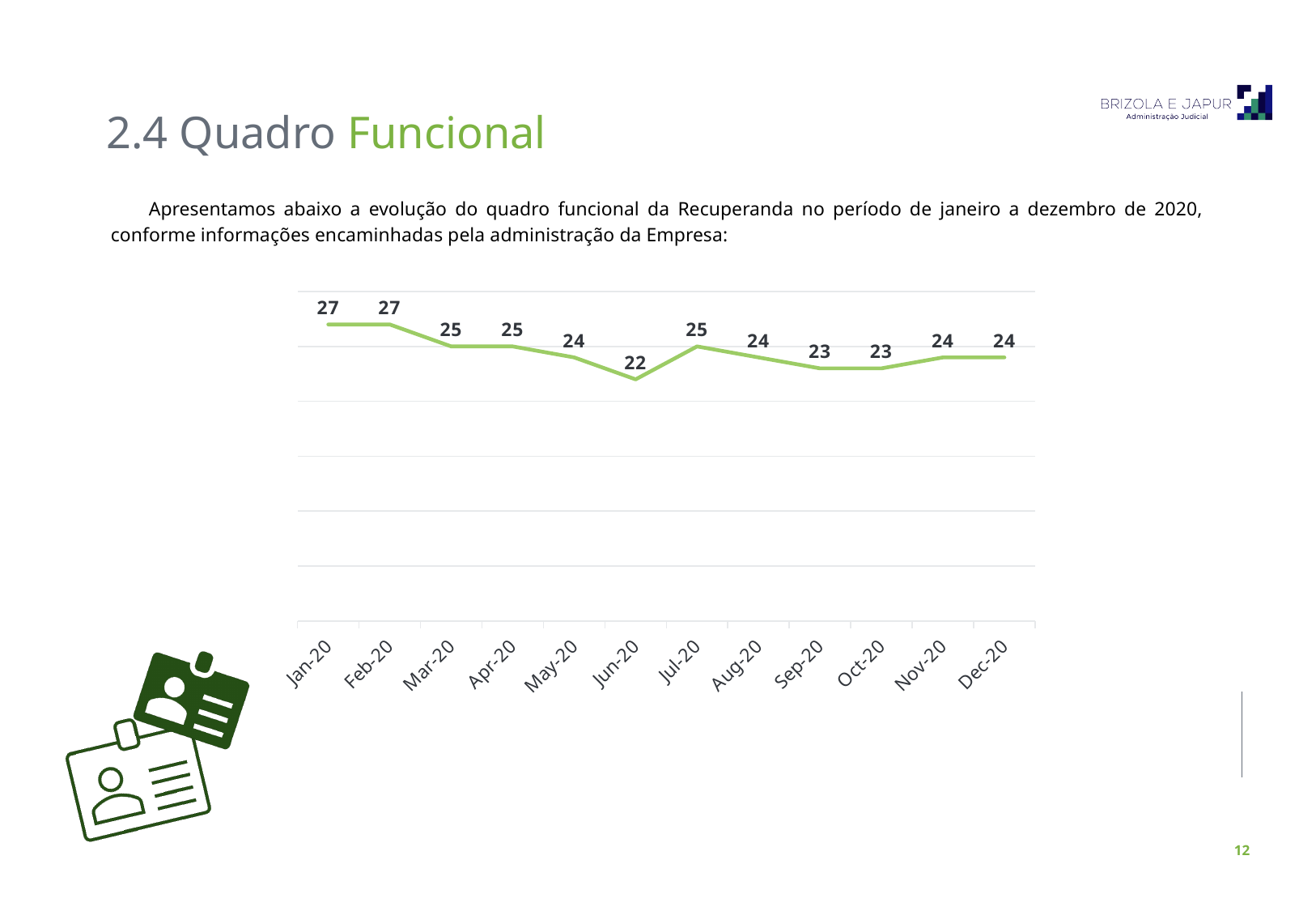
How many months are plotted on the chart? 12 What is the value for Jun-20? 22 What is the highest value shown on the chart? 27 What is the difference between the values for Feb-20 and Mar-20? 2 What is the value for Dec-20? 24 What kind of chart is shown on the slide? Line chart Which month has the lowest value? Jun-20 What is the difference between the values for Jan-20 and Jun-20? 5 Do the values generally rise or fall from Jan-20 to Dec-20? Fall What is the value for Jan-20? 27 Which is larger, the value for Jul-20 or the value for Aug-20? Jul-20 What is the value for Sep-20? 23